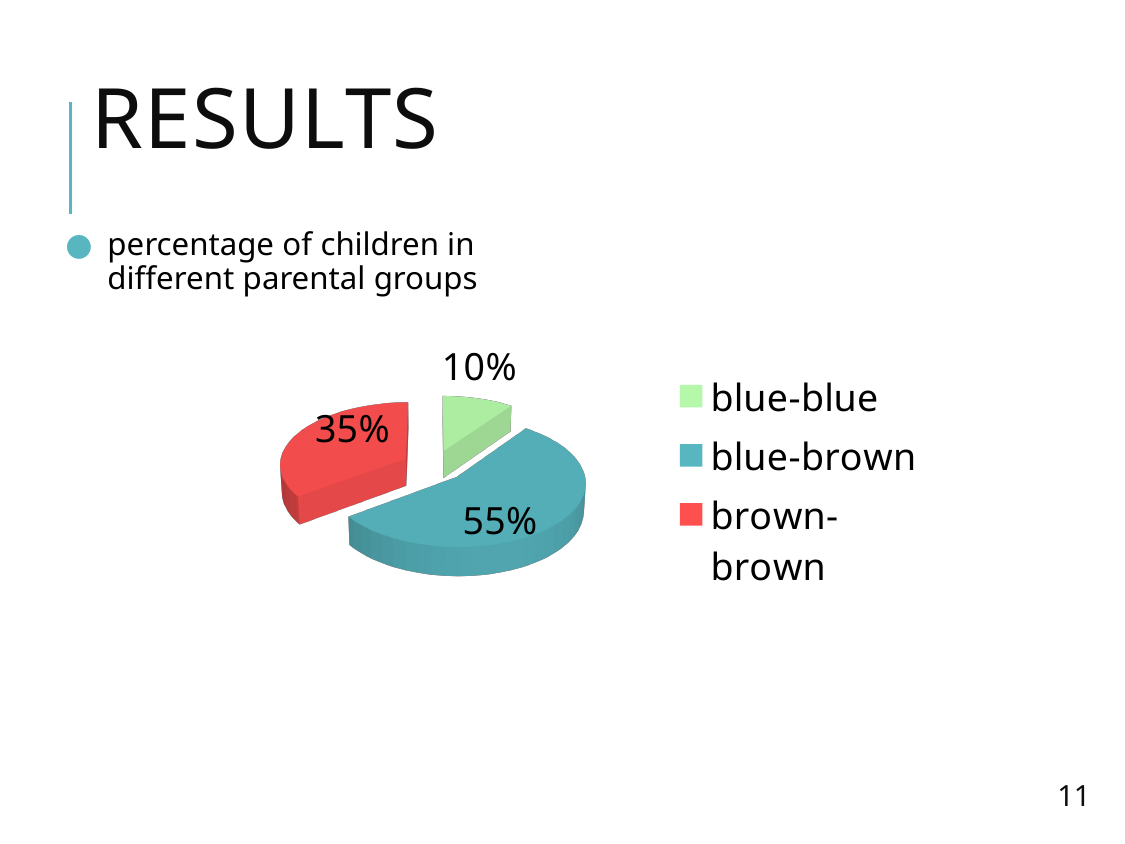
Which legend entry is shown in red? brown-brown What colour is the slice for the blue-brown group? teal What percentage of children is shown for the brown-brown parental group? 35% Which parental group has the smallest share of the pie? blue-blue What percentage of children is shown for the blue-blue parental group? 10% What is the difference in percentage points between the blue-brown and brown-brown groups? 20 What kind of chart is shown on the slide? pie chart What percentage of children is shown for the blue-brown parental group? 55% Which parental group has the largest share of the pie? blue-brown Which group has a larger share, brown-brown or blue-blue? brown-brown How many parental groups are shown in the pie chart? 3 What is the difference in percentage points between the brown-brown and blue-blue groups? 25